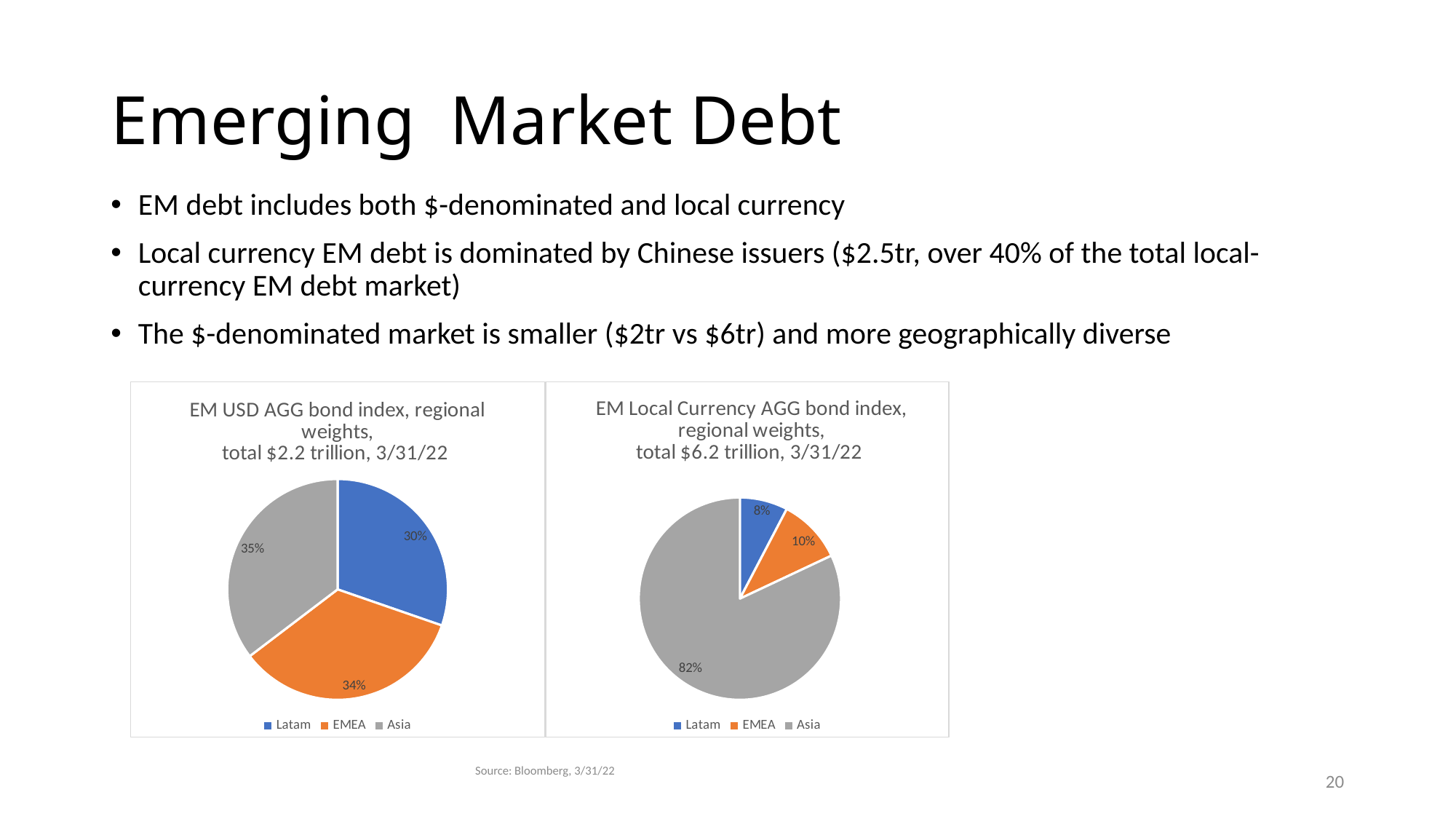
In the EM USD AGG bond index chart (left), what share does EMEA have? 34% In the EM USD AGG bond index chart (left), which region has the smallest share? Latam In the EM Local Currency AGG bond index chart (right), which region has the largest share? Asia In the EM Local Currency AGG bond index chart (right), what share does Latam have? 8% In the EM USD AGG bond index chart (left), which is larger, the Latam share or the EMEA share? EMEA In the EM USD AGG bond index chart (left), what share does Latam have? 30% In the EM Local Currency AGG bond index chart (right), what is the difference between the Asia share and the EMEA share? 72% How many regions does the legend of the EM USD AGG bond index chart (left) list? 3 In the EM USD AGG bond index chart (left), what share does Asia have? 35% In the EM Local Currency AGG bond index chart (right), which region has the smallest share? Latam In the EM Local Currency AGG bond index chart (right), what share does Asia have? 82% What kind of chart is the EM Local Currency AGG bond index chart (right)? Pie chart